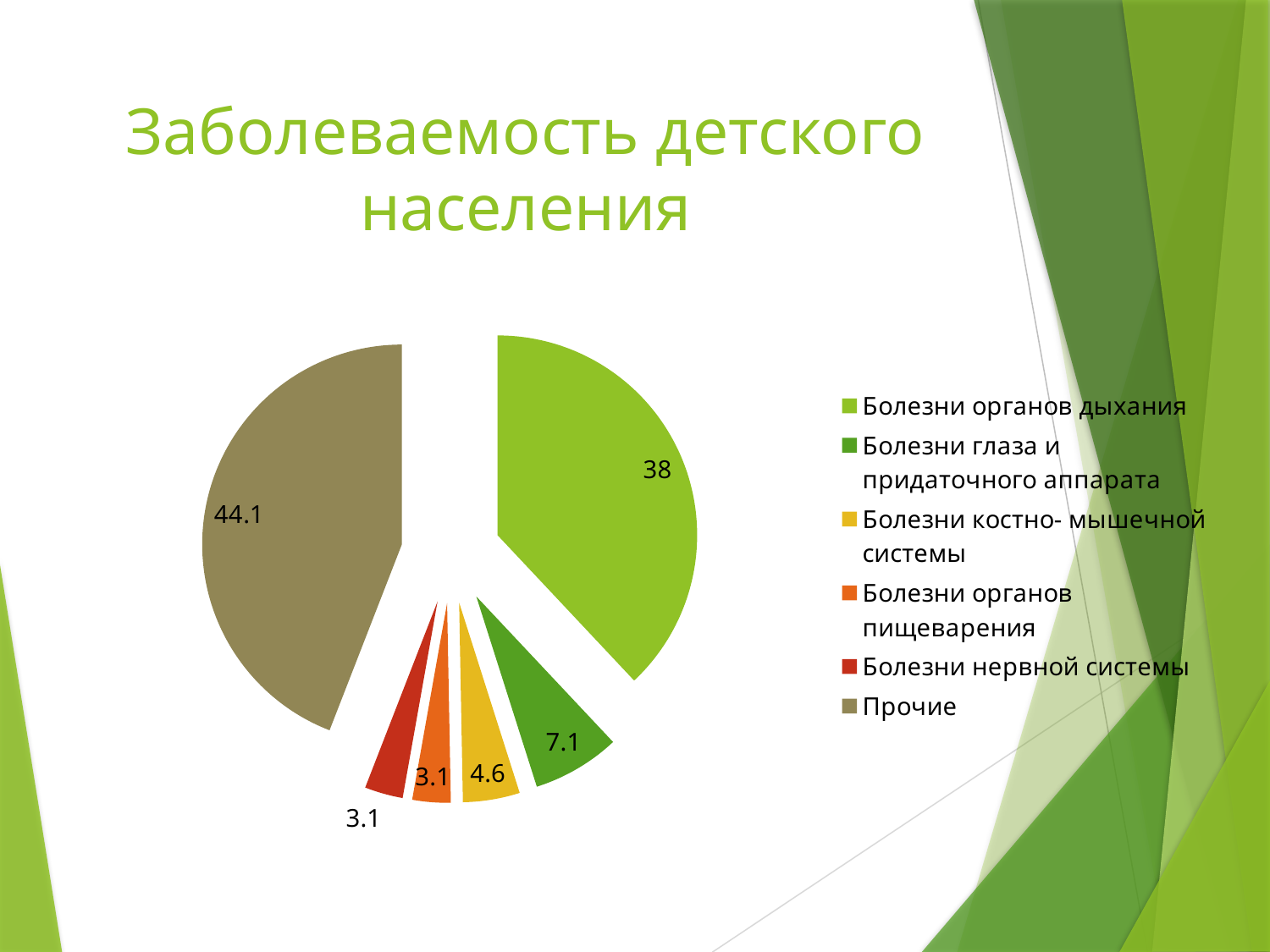
What type of chart is shown on the slide? Pie chart What is the title of the slide containing the chart? Заболеваемость детского населения What is the difference between the values for Прочие and Болезни органов дыхания? 6.1 What is the value for Болезни костно-мышечной системы? 4.6 What is the value for Болезни глаза и придаточного аппарата? 7.1 How many entries does the legend list? 6 Which is larger: Болезни глаза и придаточного аппарата or Болезни костно-мышечной системы? Болезни глаза и придаточного аппарата Which category has the largest slice of the pie? Прочие How many slices does the pie chart have? 6 What is the value for Прочие? 44.1 What is the value for Болезни органов дыхания? 38 What is the value for Болезни органов пищеварения? 3.1